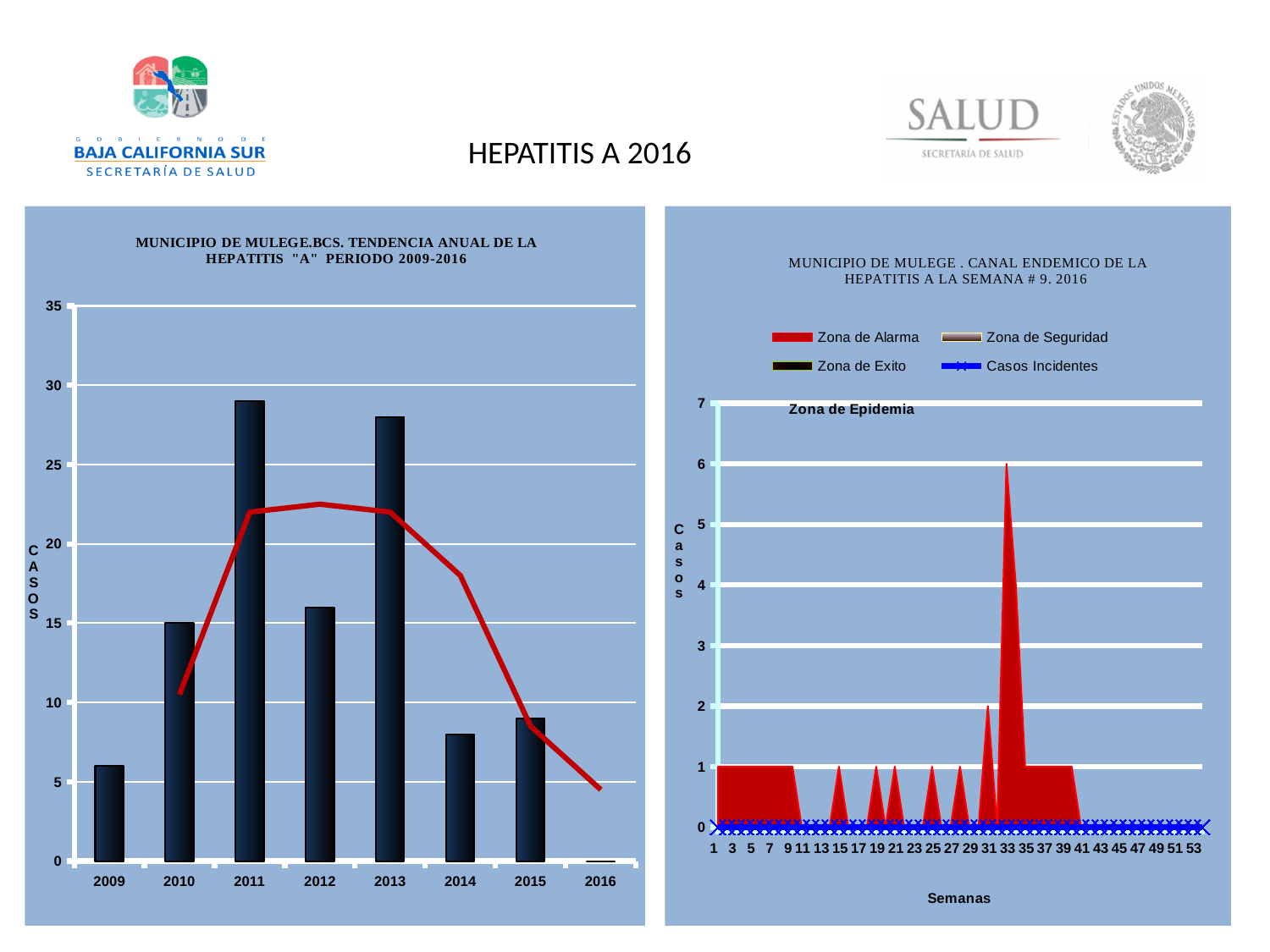
In the left chart (Tendencia anual), is the value for 2011 greater or less than 25? greater In the left chart (Tendencia anual), how many years are shown on the x axis? 8 In the left chart (Tendencia anual), what is the number of cases for 2010? 15 In the right chart (Canal endemico), what is the label of the x axis? Semanas In the left chart (Tendencia anual), which year has the larger bar, 2010 or 2014? 2010 In the left chart (Tendencia anual), which year has the larger bar, 2011 or 2012? 2011 In the left chart (Tendencia anual), is the value for 2009 greater or less than 5? greater In the left chart (Tendencia anual), is the value for 2014 greater or less than 10? less In the right chart (Canal endemico), how many series does the legend list? 4 What type of chart is the left chart, 'Tendencia anual de la Hepatitis A periodo 2009-2016'? bar chart In the left chart (Tendencia anual), which year has the lowest bar? 2016